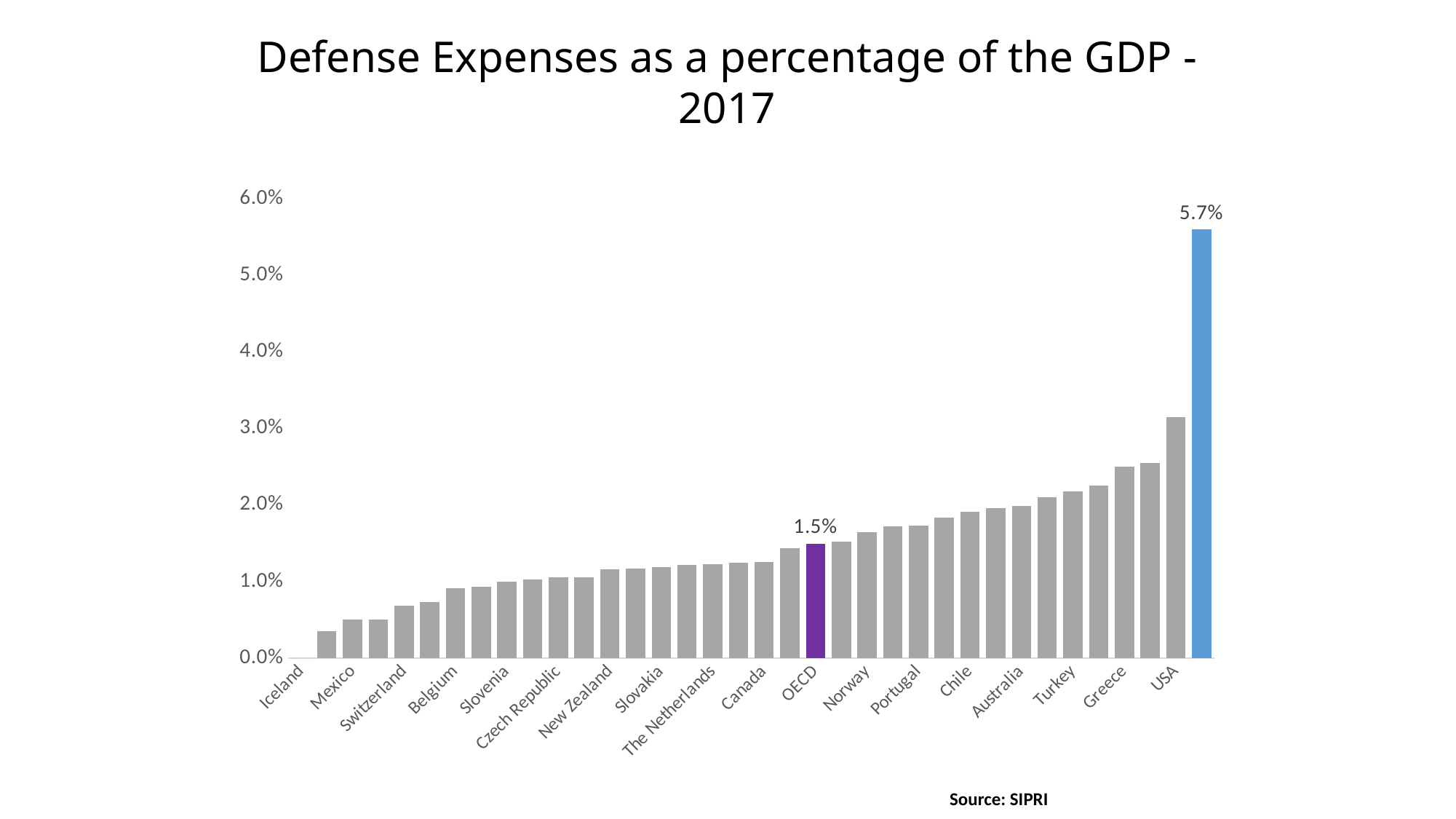
Is the value for Canada greater or less than 2.0%? less Do the values rise or fall from left to right along the x axis? rise Which is larger, the value for Greece or the value for Norway? Greece What is the title of the chart? Defense Expenses as a percentage of the GDP - 2017 Which category has the lowest value? Iceland What is the value for OECD? 1.5% What kind of chart is shown on the slide? bar chart Is the value for Greece greater or less than 2.0%? greater Is the value for Mexico greater or less than 1.0%? less